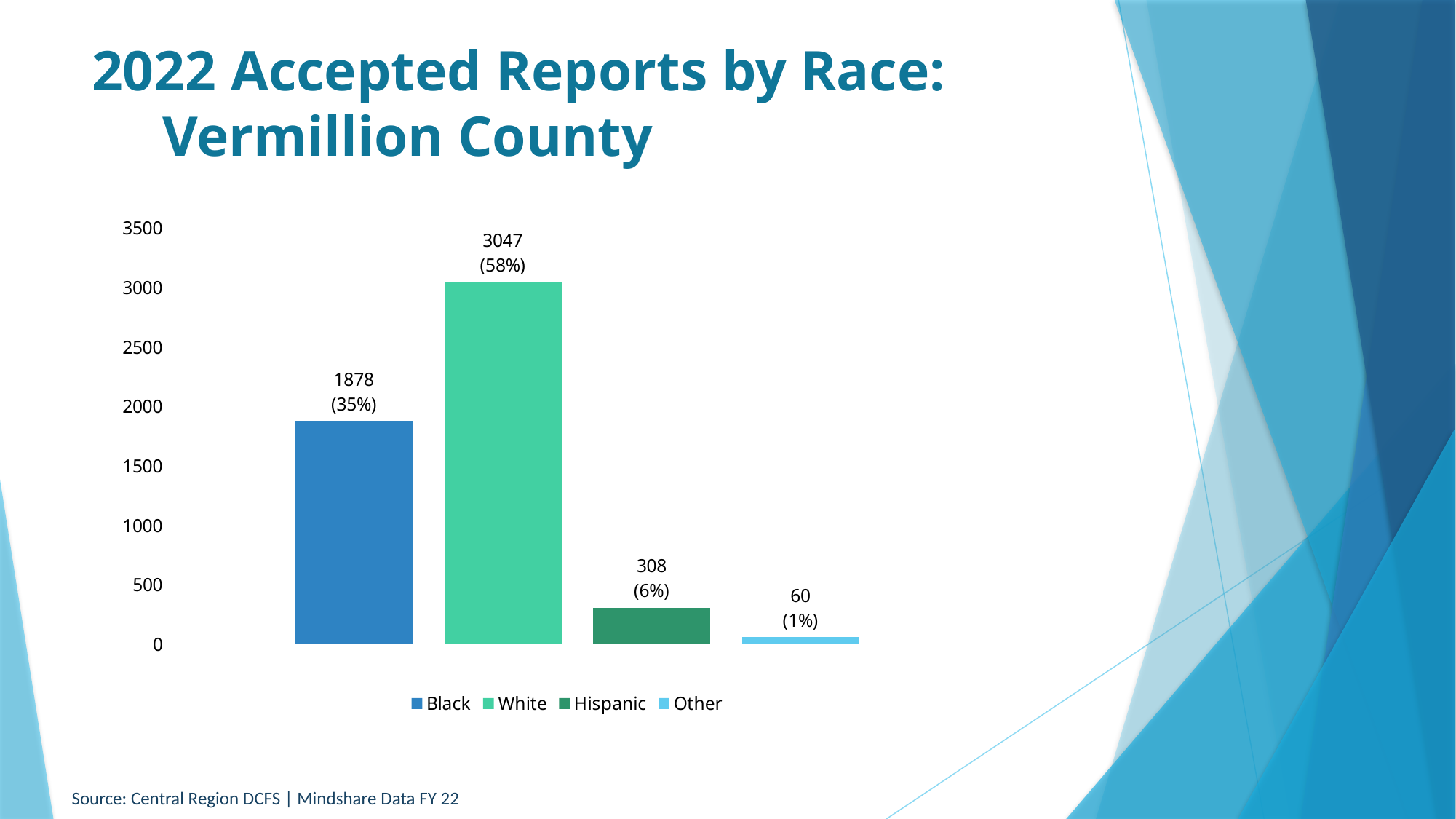
What percentage of accepted reports were for Hispanic? 6% How many accepted reports were there for Black? 1878 What is the difference between the number of accepted reports for White and for Black? 1169 What is the source cited at the bottom of the slide? Central Region DCFS | Mindshare Data FY 22 How many accepted reports were there for Other? 60 Is the value for Black greater or less than 1500? greater How many race categories are shown in the chart? 4 What kind of chart is shown on the slide? Bar chart Which race category has the highest number of accepted reports? White Which has more accepted reports, Hispanic or Other? Hispanic Which race category has the lowest number of accepted reports? Other How many accepted reports were there for White in Vermillion County in 2022? 3047